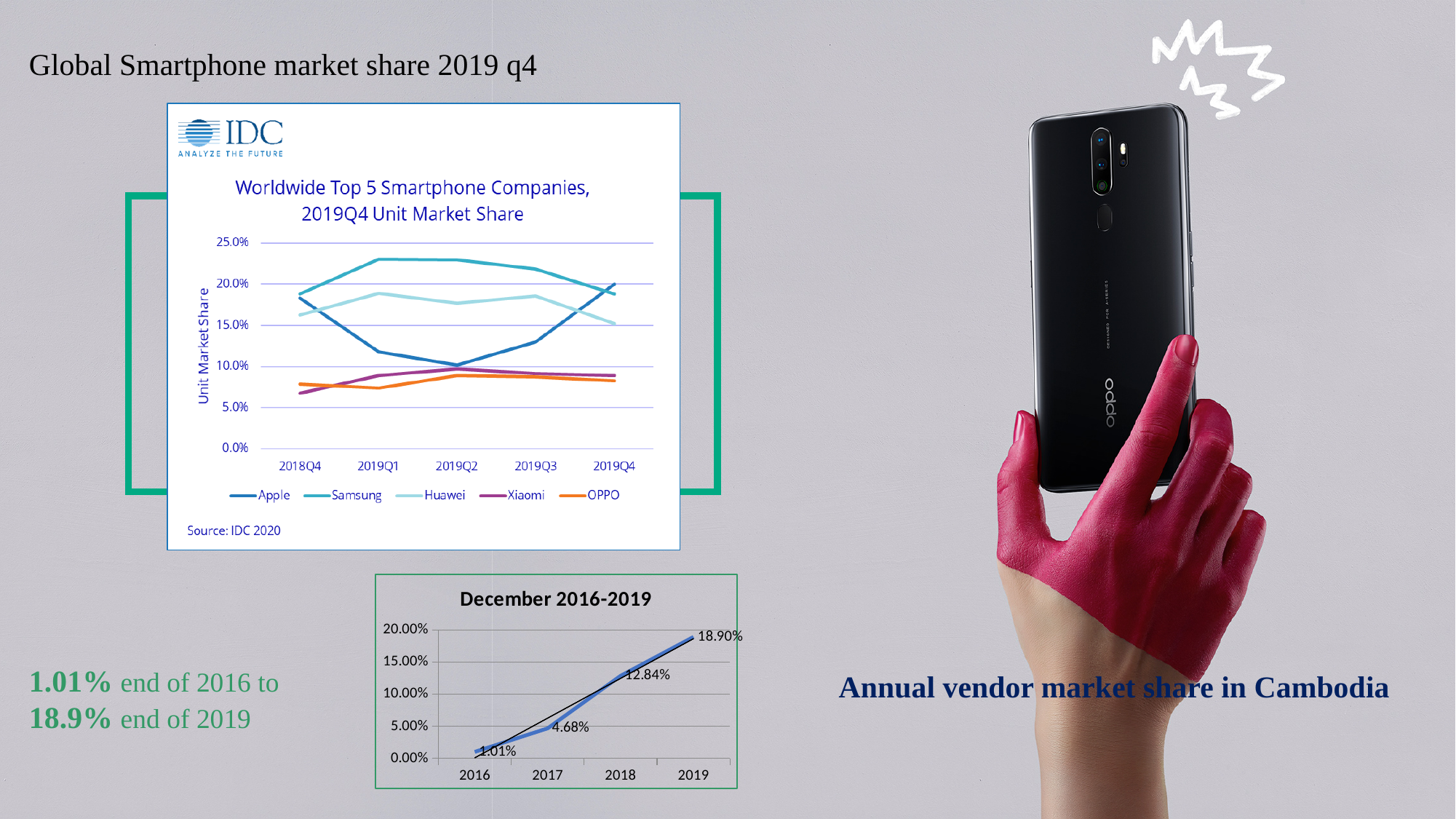
In the 'December 2016-2019' chart, what is the value for 2019? 18.90% In the 'December 2016-2019' chart, which year has the lowest value? 2016 In the 'Worldwide Top 5 Smartphone Companies' chart, which is larger in 2019Q4: Apple or Huawei? Apple In the 'Worldwide Top 5 Smartphone Companies' chart, is the value for Apple in 2019Q2 greater or less than 15.0%? less In the 'December 2016-2019' chart, what is the value for 2018? 12.84% How many series does the legend of the 'Worldwide Top 5 Smartphone Companies' chart list? 5 What kind of chart is the 'Worldwide Top 5 Smartphone Companies, 2019Q4 Unit Market Share' chart? line chart In the 'Worldwide Top 5 Smartphone Companies' chart, which company has the highest unit market share in 2019Q1? Samsung In the 'December 2016-2019' chart, do the values rise or fall from 2016 to 2019? rise How many years are plotted in the 'December 2016-2019' chart? 4 In the 'December 2016-2019' chart, what is the value for 2017? 4.68% In the 'December 2016-2019' chart, what is the difference between the 2019 and 2016 values? 17.89%